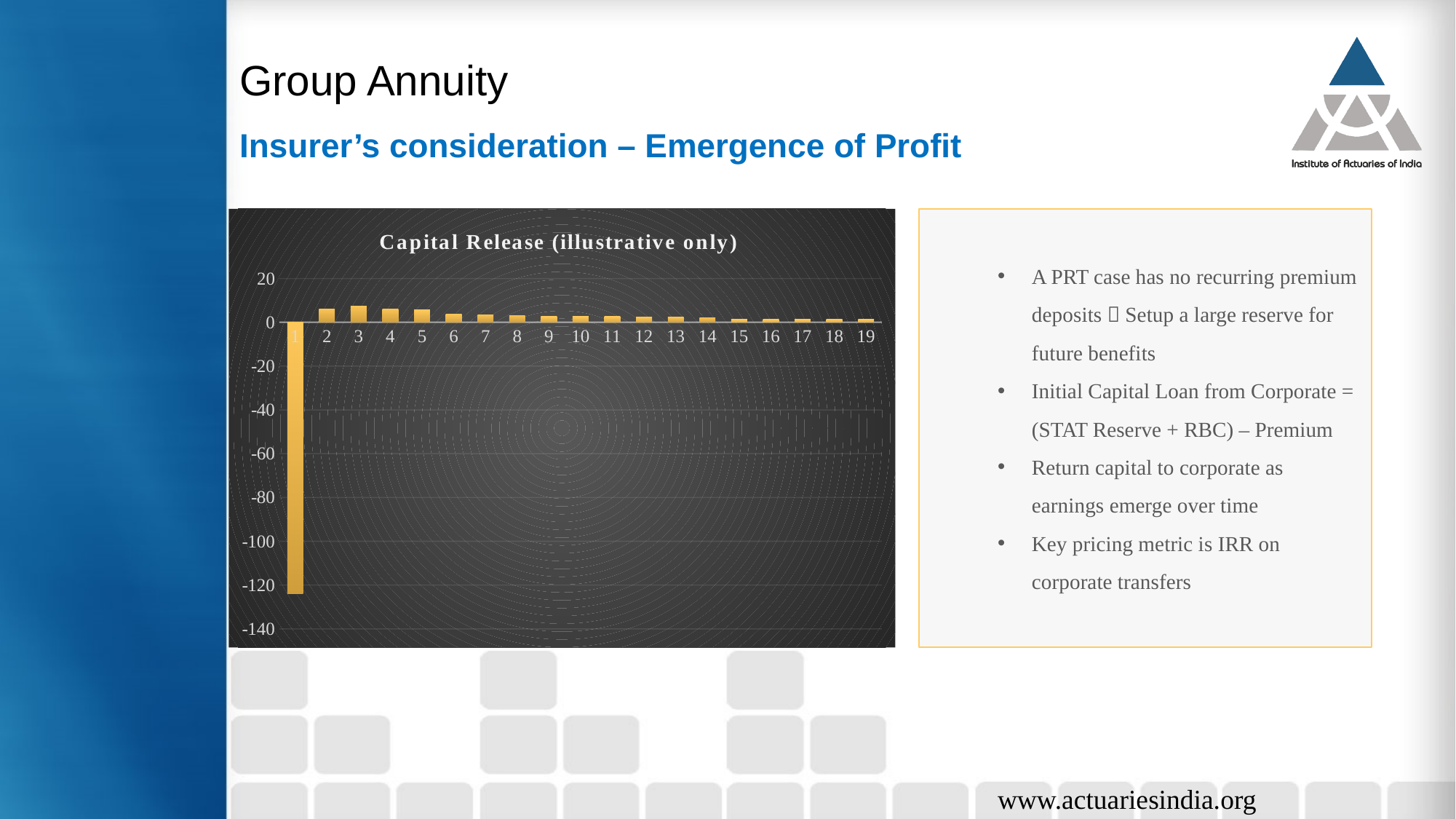
How many categories are plotted along the x axis of the chart? 19 Which is larger, the value for category 3 or the value for category 19? 3 Is the value for category 19 greater or less than -20? greater What is the lowest value shown on the y axis of the chart? -140 Is the value for category 1 greater or less than -100? less What is the title of the chart? Capital Release (illustrative only) Which category has the highest value in the chart? 3 Is the value for category 3 greater or less than 20? less What kind of chart is shown on the slide? bar chart Which is larger, the value for category 1 or the value for category 2? 2 From category 3 to category 19, do the values generally rise or fall? fall Which category has the lowest value in the chart? 1